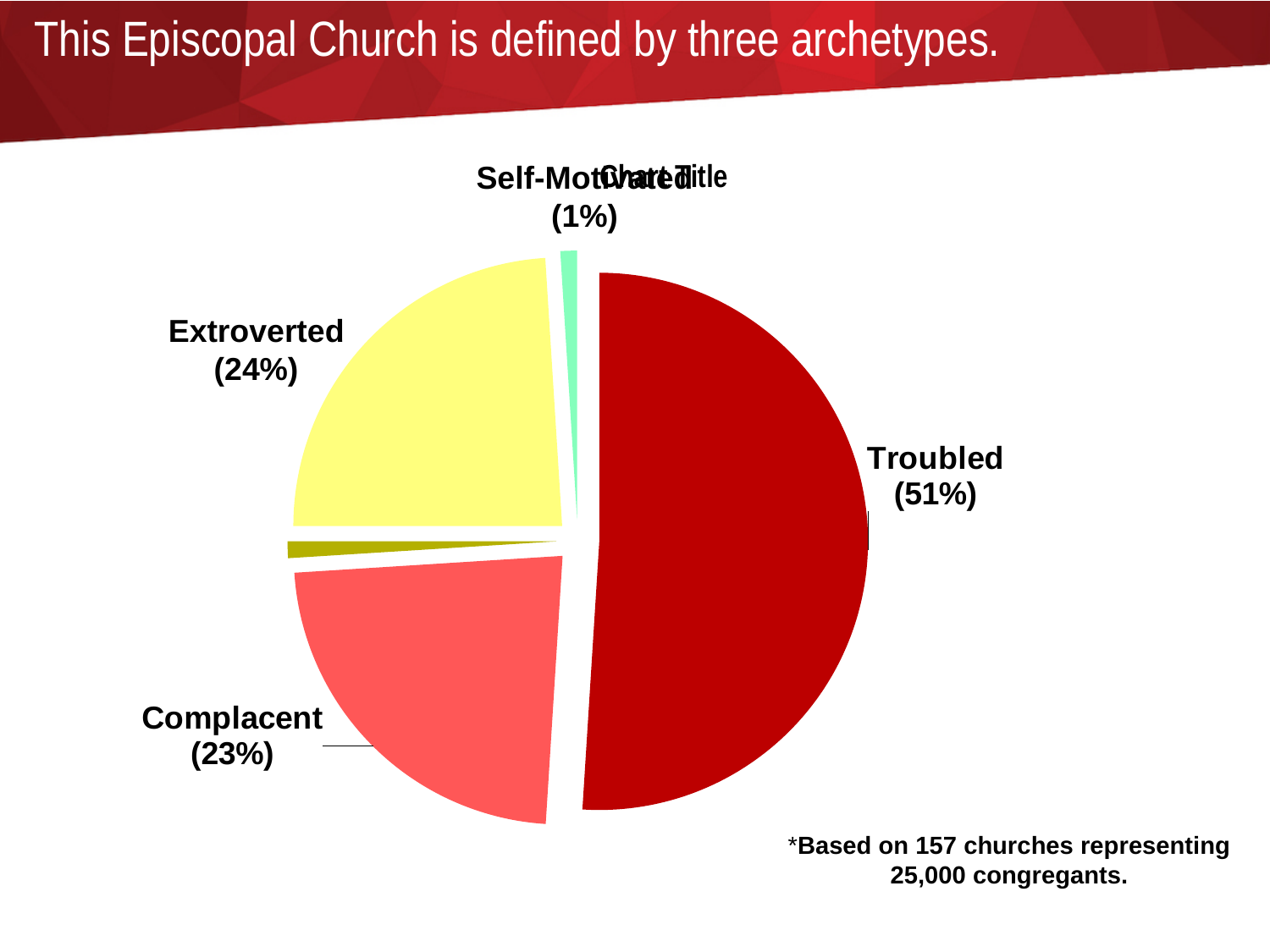
Which archetype has the largest share of the pie? Troubled Which is larger, the Troubled share or the Complacent share? Troubled What is the difference in percentage points between the Troubled and Extroverted shares? 27 What colour is the Troubled slice of the pie? dark red Which labeled archetype has the smallest share of the pie? Self-Motivated What share of the pie does the Extroverted slice represent? 24% What is the difference in percentage points between the Extroverted and Complacent shares? 1 What share of the pie does the Complacent slice represent? 23% What kind of chart is shown on the slide? pie chart What share of the pie does the Troubled slice represent? 51% Is the Troubled share greater or less than 50%? greater